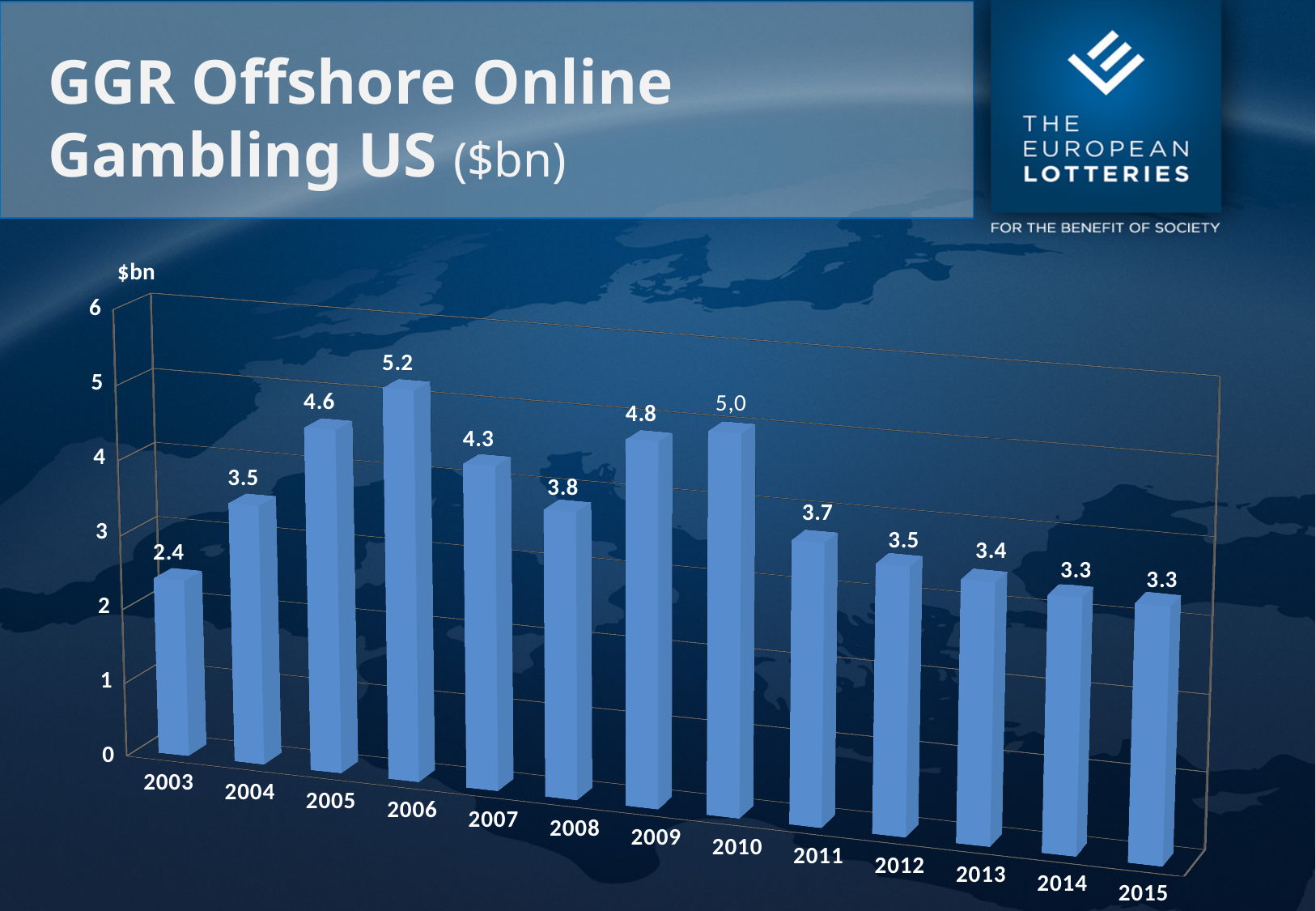
Is the value for 2008 greater or less than 4? less What kind of chart is this? bar chart What unit is shown on the y axis label? $bn Which year has the lowest value? 2003 How many years are shown on the x axis? 13 Which is larger, the value for 2009 or the value for 2011? 2009 Which year has the highest value? 2006 What is the difference between the values for 2006 and 2015? 1.9 What is the value for 2003? 2.4 What is the value for 2010? 5,0 What is the value for 2006? 5.2 Do the values rise or fall from 2010 to 2015? fall